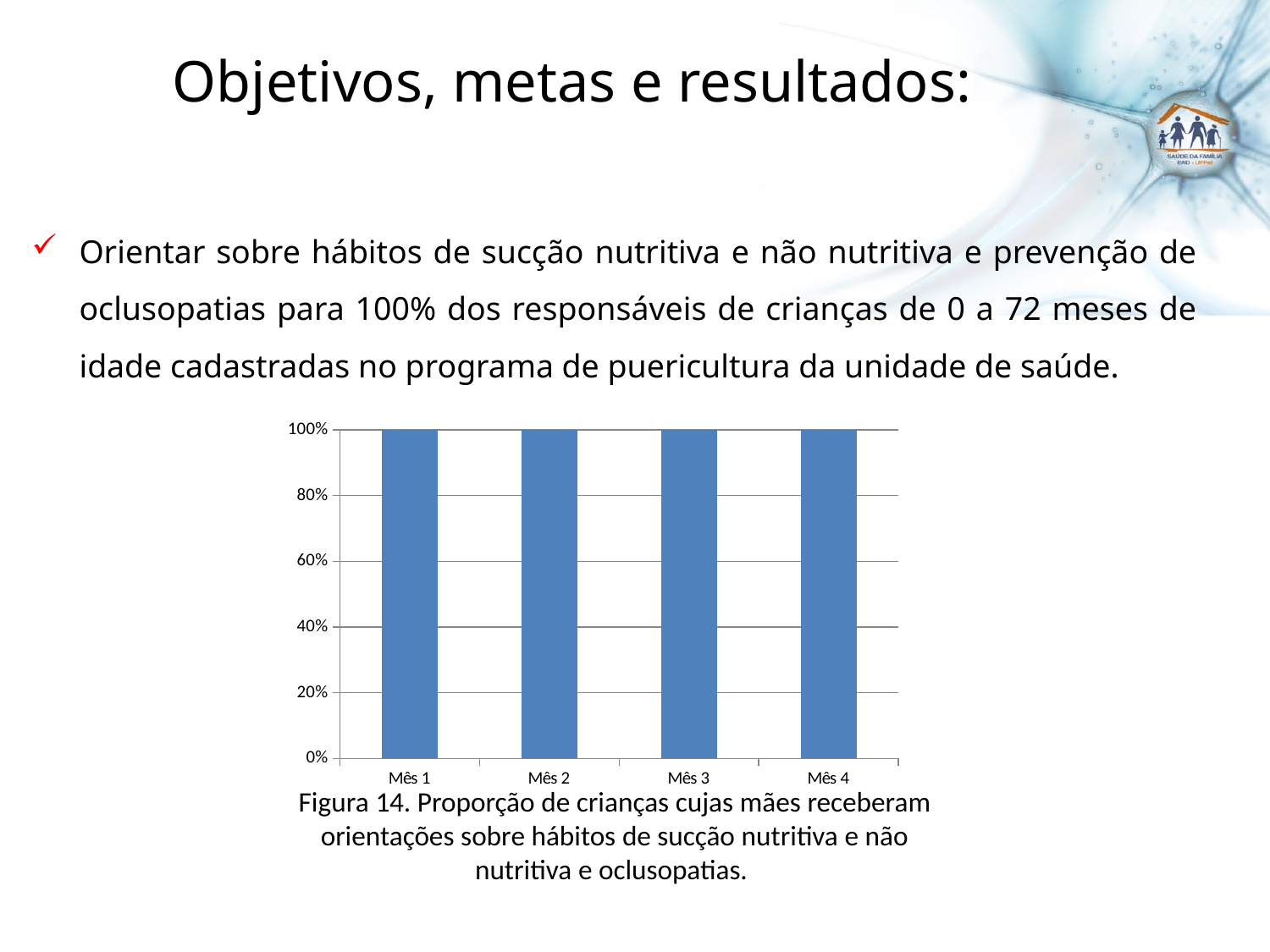
What is the value for Mês 1? 100% What kind of chart is shown on the slide? bar chart What is the value for Mês 4? 100% What figure number is given in the chart caption? Figura 14 Is the value for Mês 4 greater or less than 60%? greater How many categories are shown on the x axis of the chart? 4 Do the values rise, fall, or stay the same from Mês 1 to Mês 4? stay the same What is the highest value shown on the y axis of the chart? 100% What is the difference between the values for Mês 1 and Mês 4? 0% What is the value for Mês 3? 100% Is the value for Mês 2 greater or less than 80%? greater